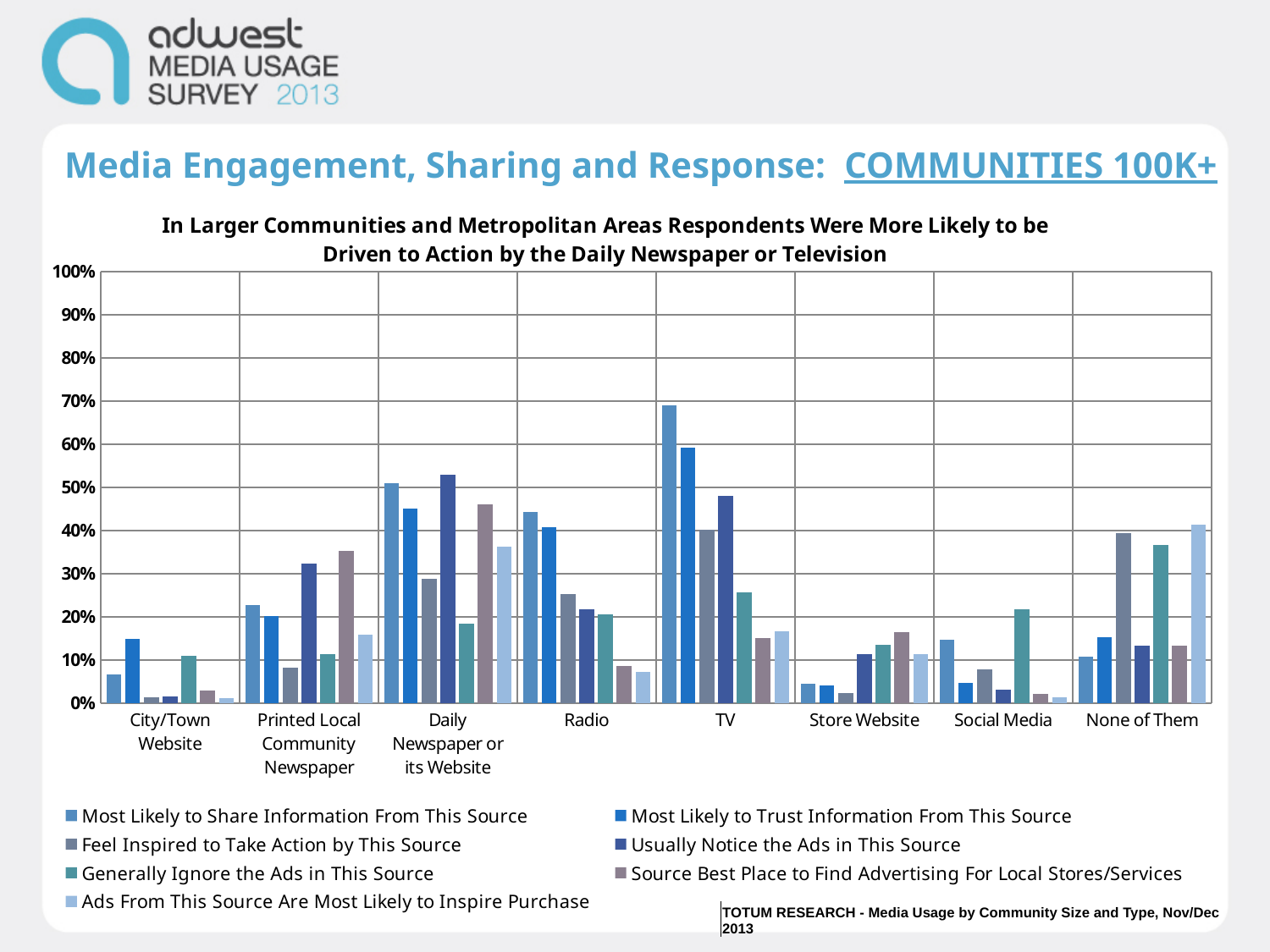
Is the value for TV in the "Most Likely to Share Information From This Source" series greater or less than 60%? greater Is the value for Social Media in the "Generally Ignore the Ads in This Source" series greater or less than 10%? greater Is the value for Printed Local Community Newspaper in the "Source Best Place to Find Advertising For Local Stores/Services" series greater or less than 30%? greater Which category has the highest value for "Most Likely to Share Information From This Source"? TV For "Most Likely to Trust Information From This Source", which is larger: Daily Newspaper or its Website, or Radio? Daily Newspaper or its Website What is the title of the chart? In Larger Communities and Metropolitan Areas Respondents Were More Likely to be Driven to Action by the Daily Newspaper or Television What kind of chart is shown on the slide? Bar chart How many media source categories are shown along the x axis? 8 How many series does the legend list? 7 For "Feel Inspired to Take Action by This Source", which is larger: TV or Daily Newspaper or its Website? TV Which category has the highest value for "Ads From This Source Are Most Likely to Inspire Purchase"? None of Them